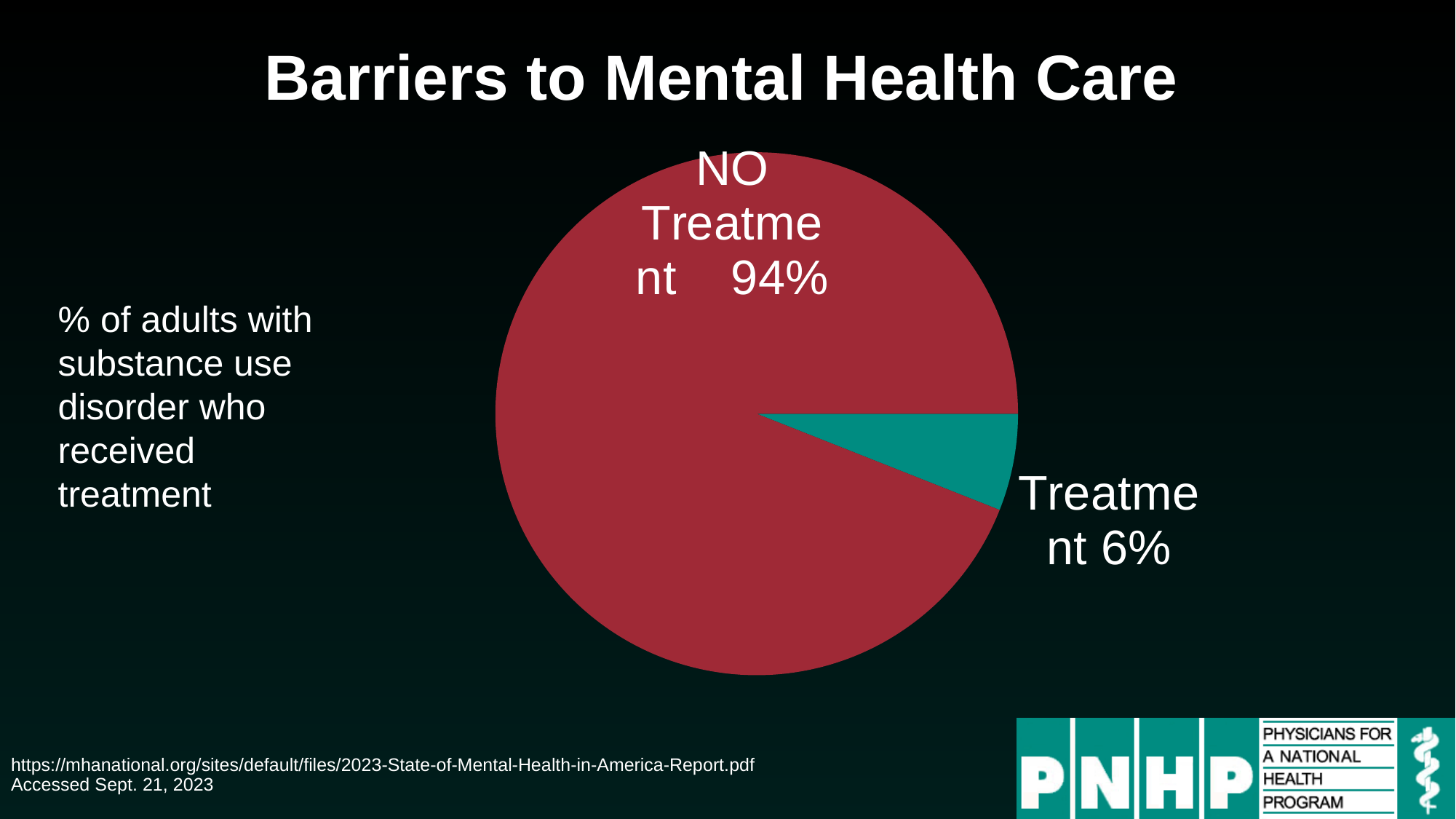
What colour is the Treatment slice of the pie chart? teal What percentage of adults with substance use disorder received treatment? 6% Which is larger, the NO Treatment slice or the Treatment slice? NO Treatment What share of the pie does the Treatment slice represent? 6% How many slices does the pie chart have? 2 What is the difference in percentage points between the NO Treatment slice and the Treatment slice? 88 What is the title of the slide containing the pie chart? Barriers to Mental Health Care Which slice of the pie is the smallest? Treatment Which slice of the pie is the largest? NO Treatment What kind of chart is shown on the slide? pie chart What percentage of adults with substance use disorder received NO treatment? 94%